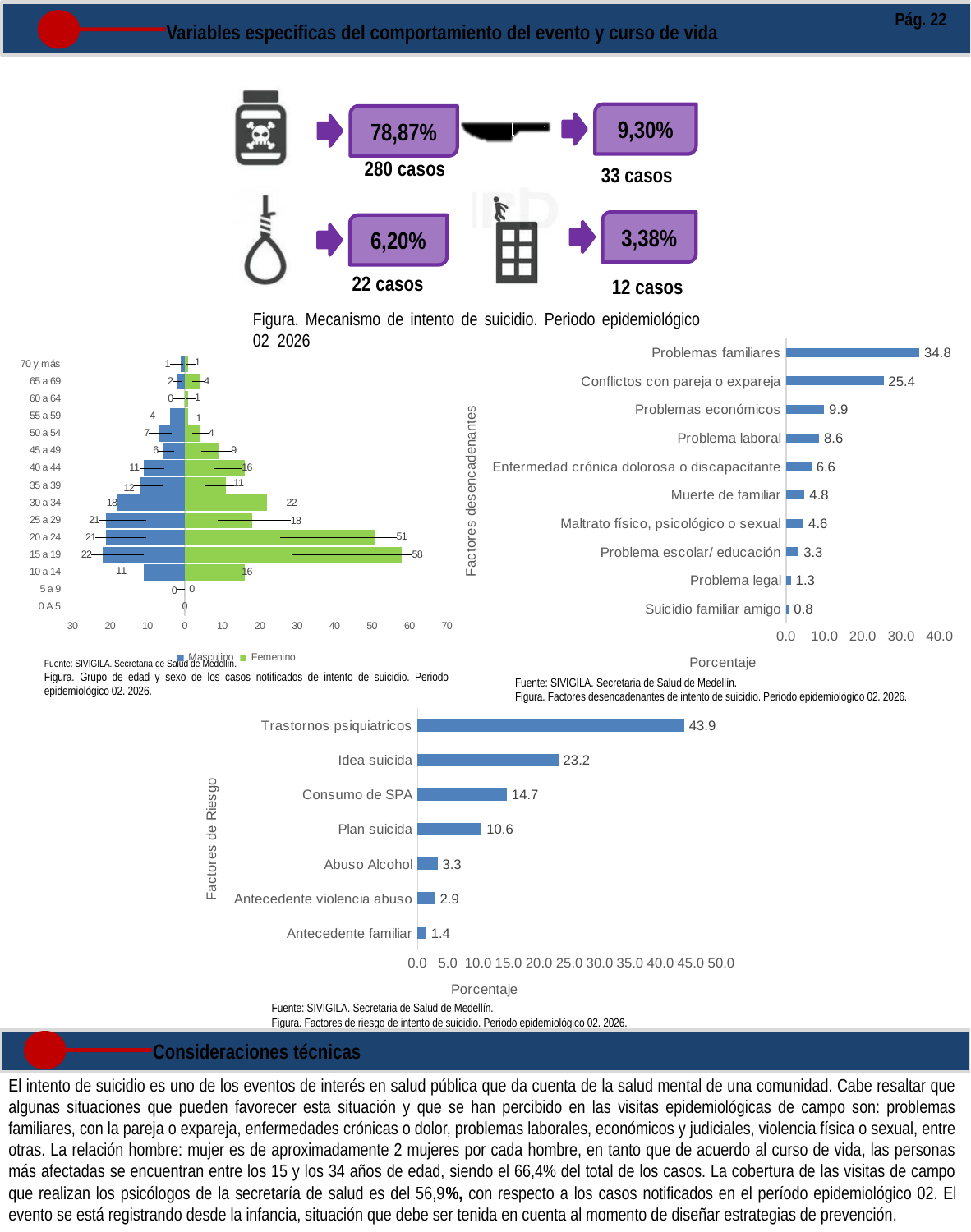
What kind of chart is the 'Factores de Riesgo' chart? Bar chart In the 'Factores de Riesgo' chart, what is the value for Consumo de SPA? 14.7 In the 'Factores de Riesgo' chart, how many risk factors are shown? 7 In the 'Factores desencadenantes' chart, what is the value for Problemas familiares? 34.8 In the 'Factores de Riesgo' chart, which risk factor has the highest percentage? Trastornos psiquiatricos In the age group and sex chart (bottom left), how many series does the legend list? 2 In the 'Factores desencadenantes' chart, what is the difference between Problemas familiares and Conflictos con pareja o expareja? 9.4 In the 'Factores de Riesgo' chart, which is larger: Plan suicida or Abuso Alcohol? Plan suicida In the age group and sex chart (bottom left), what is the Masculino value for the 25 a 29 age group? 21 In the 'Factores desencadenantes' chart, how many factors are listed? 10 In the 'Factores desencadenantes' chart, which factor has the lowest percentage? Suicidio familiar amigo In the age group and sex chart (bottom left), what is the Femenino value for the 15 a 19 age group? 58